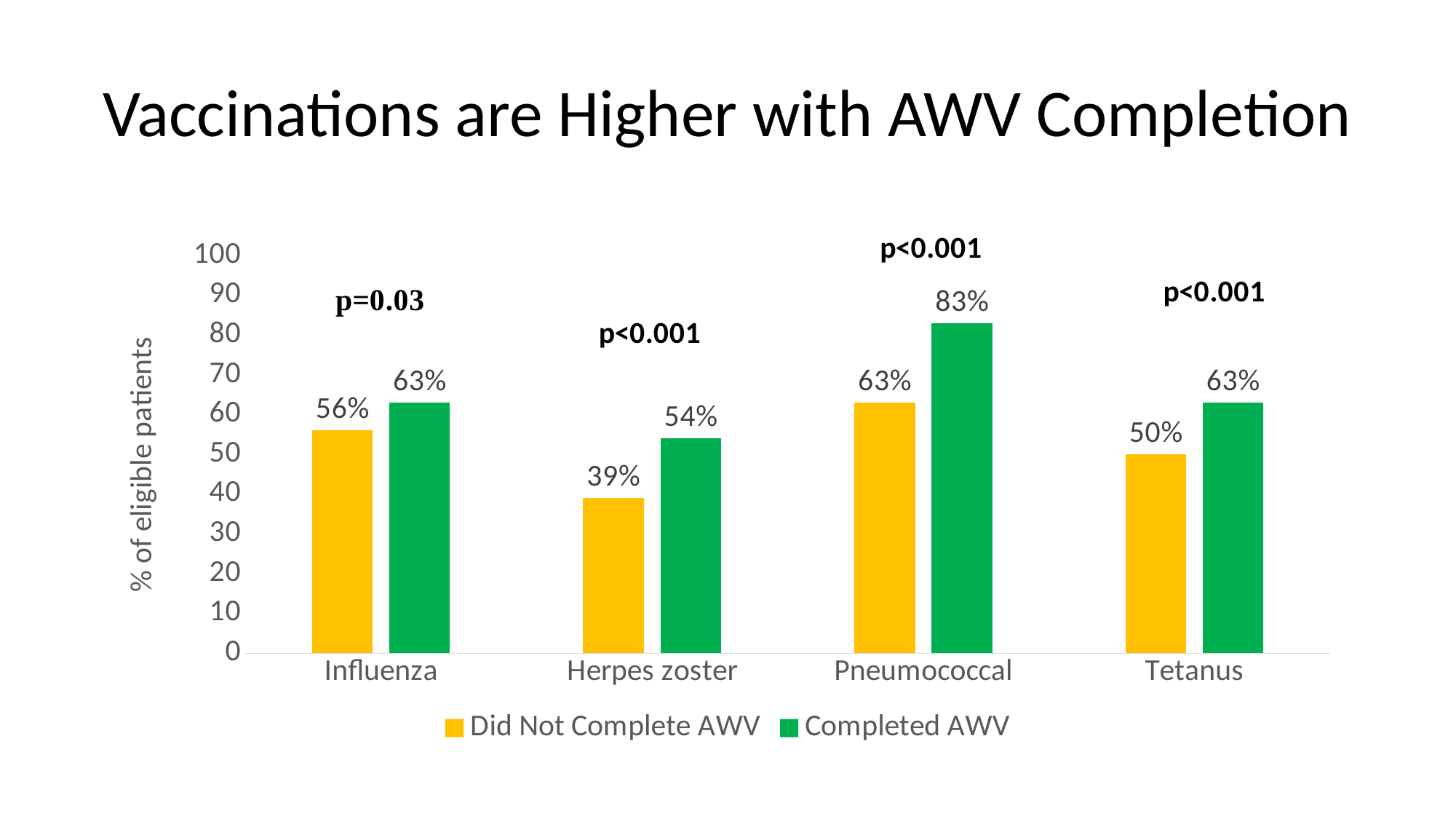
What kind of chart is shown on the slide? Bar chart What is the difference between the Completed AWV and Did Not Complete AWV rates for Herpes zoster vaccination? 15% What is the Herpes zoster vaccination rate for patients who did not complete AWV? 39% How many series does the legend list? 2 What p-value is shown above the Influenza bars? p=0.03 Which vaccination has the lowest rate among patients who did not complete AWV? Herpes zoster What percentage of eligible patients who completed AWV received the Pneumococcal vaccination? 83% What is the difference between the Completed AWV and Did Not Complete AWV rates for Pneumococcal vaccination? 20% How many vaccination categories are shown on the x axis? 4 For Influenza, which group has the higher vaccination rate: Completed AWV or Did Not Complete AWV? Completed AWV Which vaccination has the highest rate among patients who completed AWV? Pneumococcal What is the Tetanus vaccination rate for patients who did not complete AWV? 50%